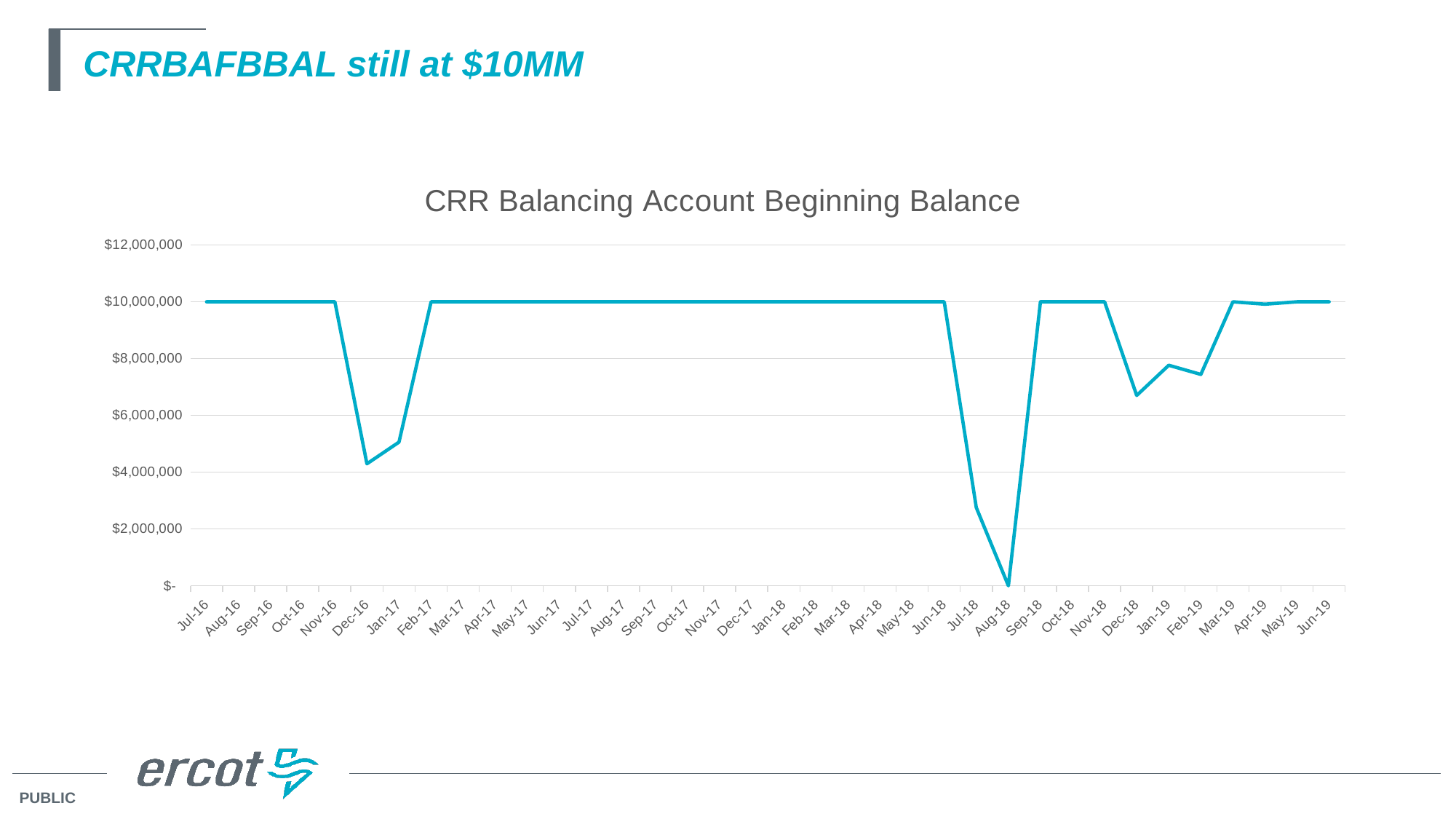
Which is larger, the value for Dec-16 or the value for Jan-17? Jan-17 Does the balance rise or fall from Jun-18 to Aug-18? fall What is the CRR Balancing Account Beginning Balance for Aug-18? $- Which month has the lowest CRR Balancing Account Beginning Balance? Aug-18 What is the CRR Balancing Account Beginning Balance for Jul-16? $10,000,000 Is the value for Dec-18 greater or less than $6,000,000? greater Is the value for Jul-18 greater or less than $4,000,000? less Which is larger, the value for Dec-18 or the value for Jan-19? Jan-19 What is the title of the chart? CRR Balancing Account Beginning Balance Is the value for Dec-16 greater or less than $6,000,000? less What kind of chart is shown on the slide? line chart How many monthly points are plotted along the x axis, from Jul-16 to Jun-19? 36